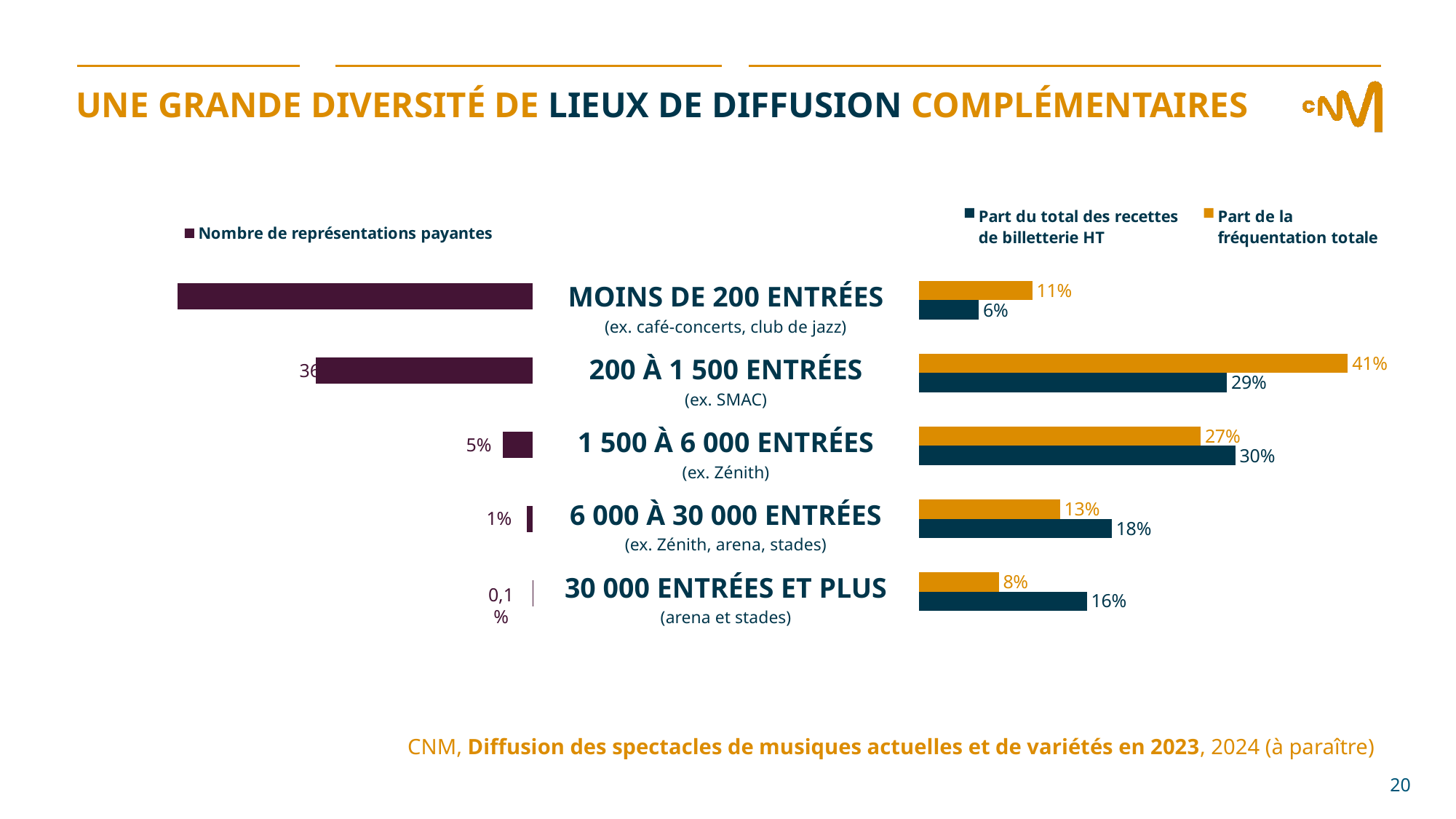
In the right-hand chart, which category has the highest 'Part de la fréquentation totale'? 200 à 1 500 entrées In the right-hand chart, what is the 'Part du total des recettes de billetterie HT' for '1 500 à 6 000 entrées'? 30% How many series does the legend of the right-hand chart list? 2 In the right-hand chart, what is the difference between the 'Part de la fréquentation totale' and the 'Part du total des recettes de billetterie HT' for '30 000 entrées et plus'? 8% In the right-hand chart, what is the 'Part de la fréquentation totale' for '200 à 1 500 entrées'? 41% In the left-hand chart 'Nombre de représentations payantes', what is the value for '30 000 entrées et plus'? 0,1 % In the right-hand chart, for '6 000 à 30 000 entrées', which is larger: the 'Part du total des recettes de billetterie HT' or the 'Part de la fréquentation totale'? Part du total des recettes de billetterie HT In the left-hand chart 'Nombre de représentations payantes', what is the value for '1 500 à 6 000 entrées'? 5% In the right-hand chart, which category has the lowest 'Part du total des recettes de billetterie HT'? Moins de 200 entrées In the left-hand chart 'Nombre de représentations payantes', which category has the largest bar? Moins de 200 entrées In the right-hand chart, what is the 'Part du total des recettes de billetterie HT' for 'Moins de 200 entrées'? 6% What kind of chart is the left-hand chart 'Nombre de représentations payantes'? Bar chart